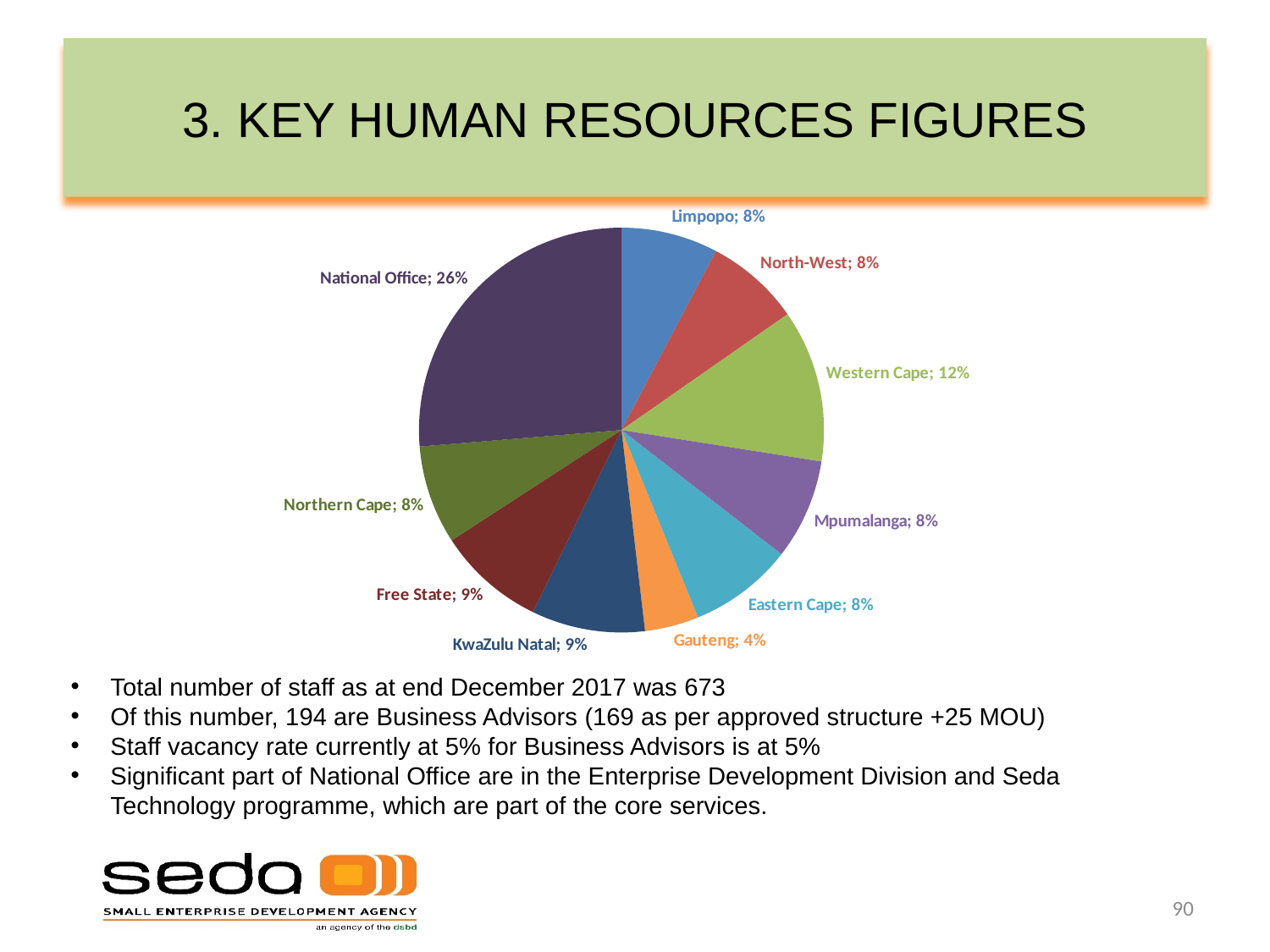
What kind of chart is shown on the slide? pie chart What percentage of staff is in Gauteng? 4% How many slices does the pie chart have? 10 What share of staff is in the National Office? 26% What colour is the National Office slice? purple Which has a larger share, Free State or Gauteng? Free State Which has a larger share, Western Cape or Mpumalanga? Western Cape Which category has the smallest share of the pie? Gauteng Which category has the largest share of the pie? National Office What percentage of staff is in the Western Cape? 12% What is the difference in percentage points between the National Office and Western Cape shares? 14 What percentage of staff is in KwaZulu Natal? 9%